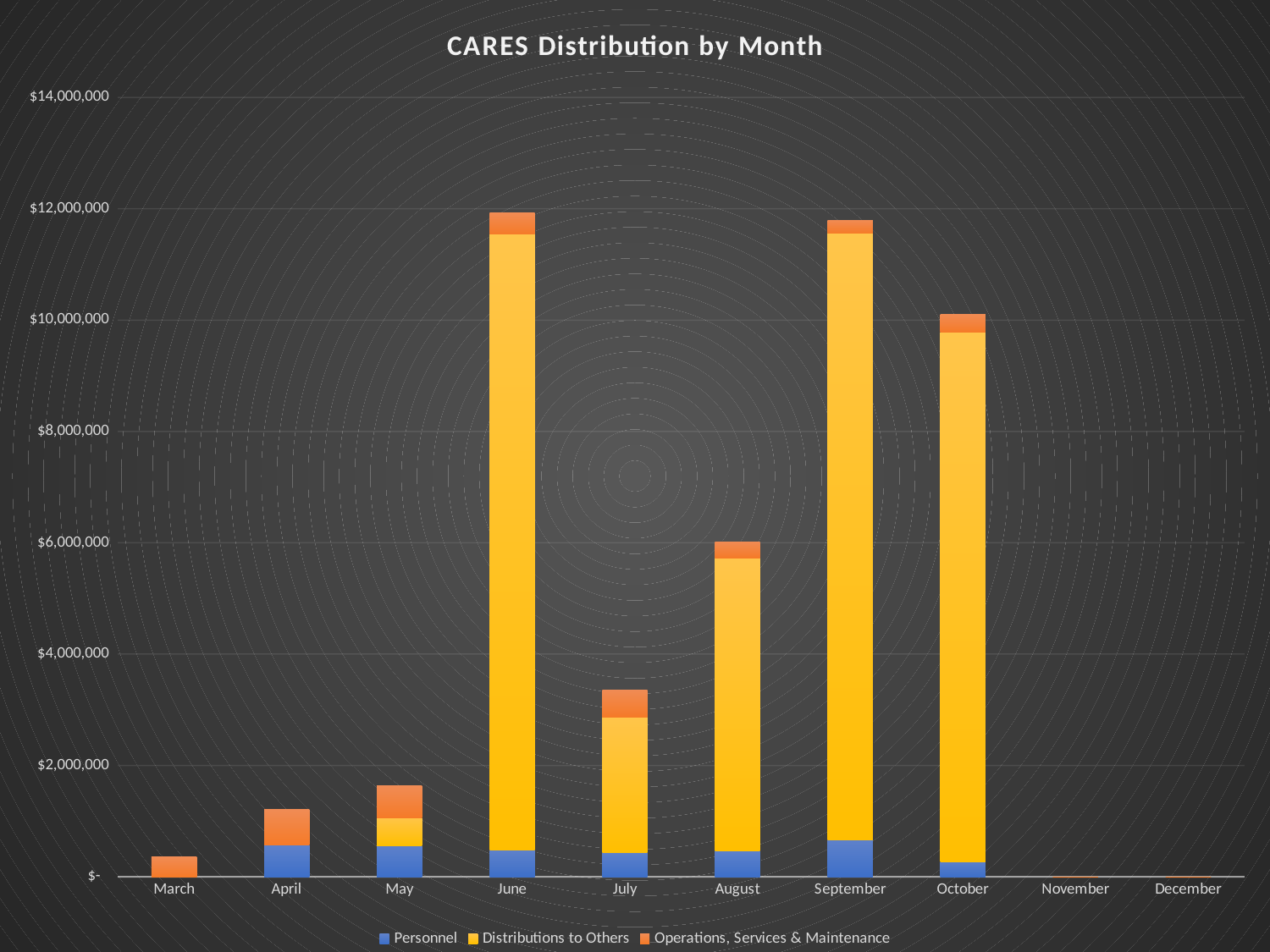
Which colour represents Personnel in the chart? Blue How many series does the legend list? 3 Is the total value for October greater or less than $8,000,000? greater Do the monthly totals rise or fall from March to June? Rise What is the title of the chart? CARES Distribution by Month Which month has the larger total, June or August? June Is the total value for July greater or less than $2,000,000? greater Is the total value for June greater or less than $10,000,000? greater How many months are shown on the x axis? 10 Which month has the larger total, April or May? May What kind of chart is shown on the slide? Stacked bar chart